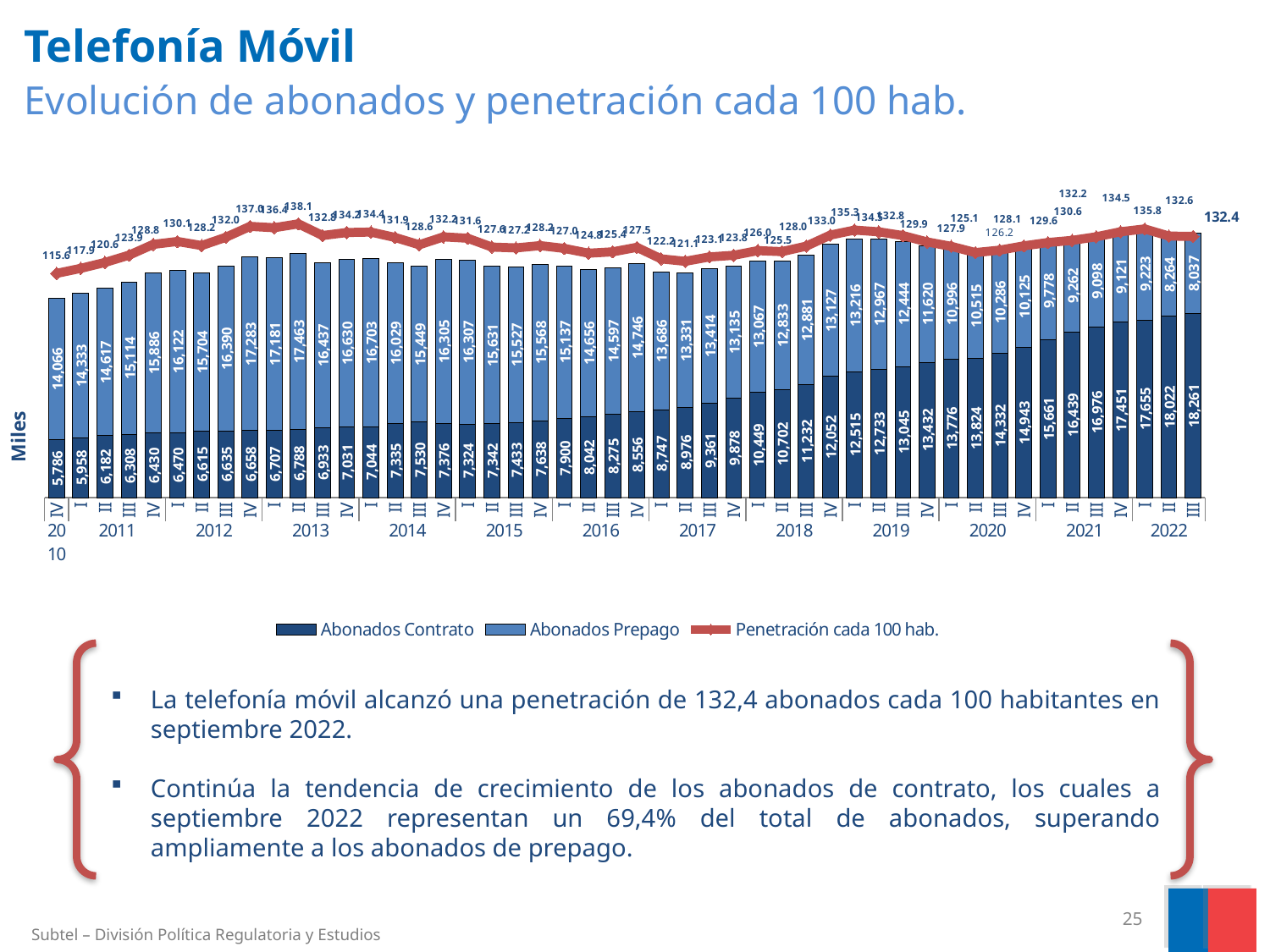
In which quarter does the Penetración cada 100 hab. line reach its highest value? II 2013 What is the total of the stacked bar (Contrato plus Prepago) for III 2022? 26,298 In III 2022, which is larger: Abonados Contrato or Abonados Prepago? Abonados Contrato What is the value of Abonados Contrato for I 2022? 17,655 What is the value of Penetración cada 100 hab. for III 2022? 132.4 Do the Abonados Contrato values rise or fall from IV 2010 to III 2022? Rise In which quarter is the Penetración cada 100 hab. line at its lowest value? IV 2010 What is the difference between Abonados Contrato in III 2022 and in IV 2010? 12,475 What kind of chart is shown on the slide? A stacked bar chart with a line How many series does the legend list? 3 What is the value of Abonados Prepago for III 2022? 8,037 What is the value of Abonados Contrato for III 2022? 18,261